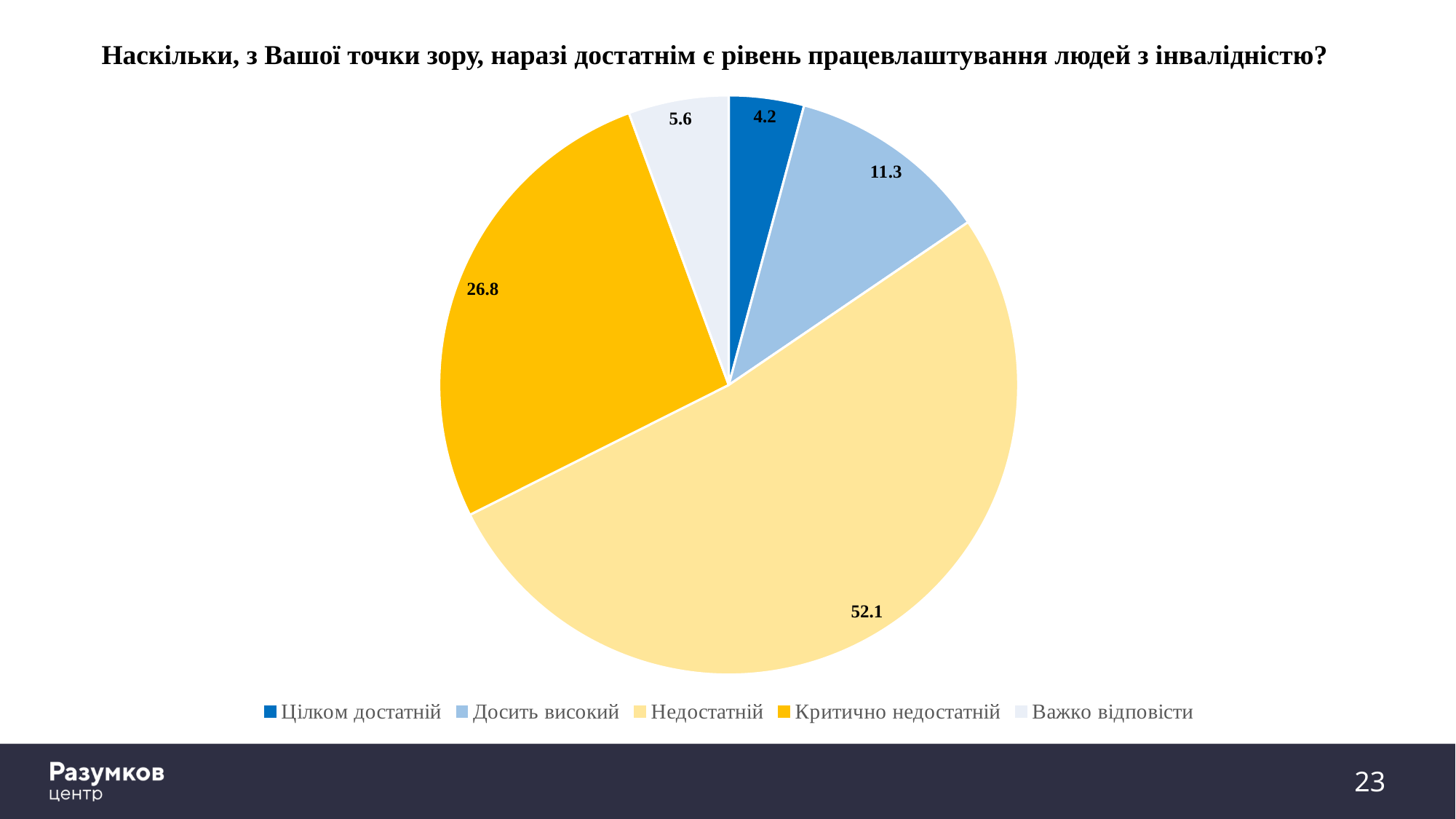
What type of chart is shown on the slide? Pie chart How many entries does the legend list? 5 Which category has the largest slice? Недостатній Which category has the smallest slice? Цілком достатній What is the value for "Цілком достатній"? 4.2 How many slices does the pie chart have? 5 What is the value for "Важко відповісти"? 5.6 What is the value for "Критично недостатній"? 26.8 Which is larger, the value for "Досить високий" or the value for "Важко відповісти"? Досить високий What is the value for "Досить високий"? 11.3 What is the value for "Недостатній"? 52.1 What is the difference between the values for "Недостатній" and "Критично недостатній"? 25.3